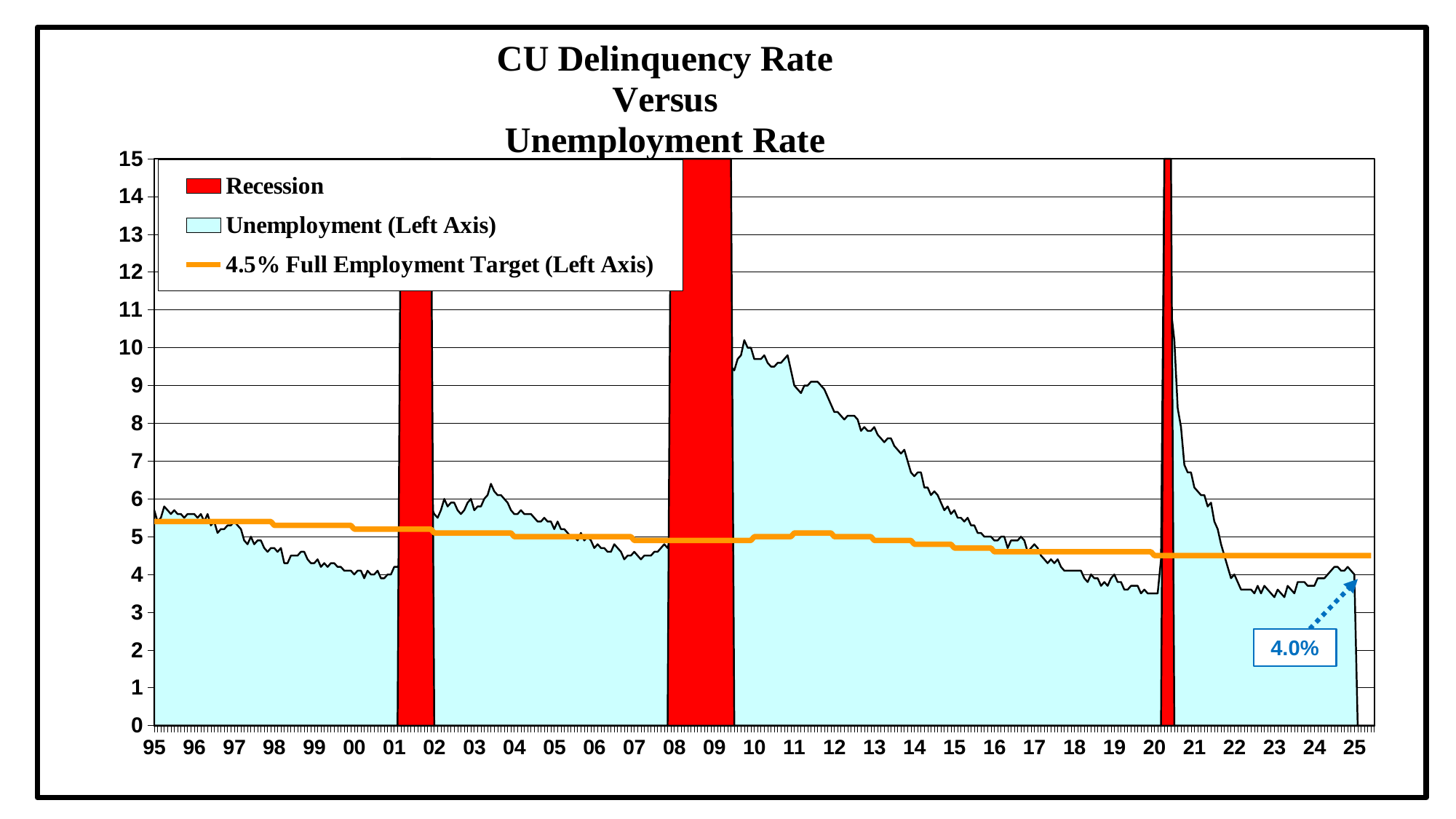
Does the unemployment rate rise or fall from 2010 to 2019? fall How many recession periods are shaded on the chart? 3 What full employment target value is named in the legend? 4.5% What is the title of the chart? CU Delinquency Rate Versus Unemployment Rate Is the unemployment rate in 2003 greater or less than 5? greater How many entries does the chart's legend list? 3 Is the peak unemployment rate in 2020 greater or less than 8? greater Which year has the higher unemployment rate, 2010 or 2019? 2010 Is the unemployment rate in 2010 greater or less than 9? greater What kind of chart is used to show the unemployment rate? area chart What is the unemployment rate value labeled at the end of the series in 2025? 4.0%